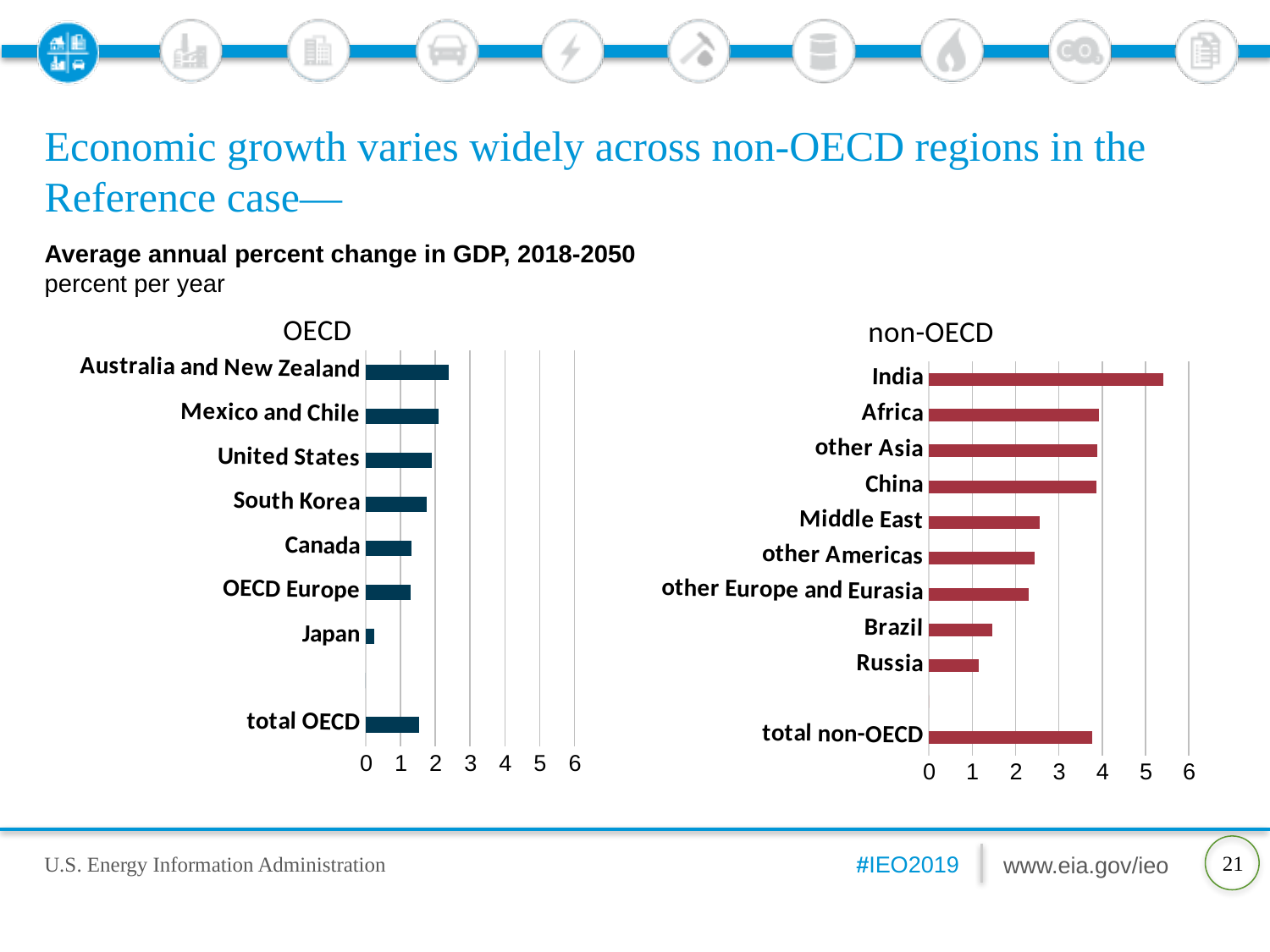
In the OECD chart, which is larger, the value for Canada or the value for Japan? Canada In the OECD chart, is the value for Australia and New Zealand greater or less than 2? greater In the non-OECD chart, is the value for India greater or less than 5? greater How many bars are shown in the non-OECD chart, including the total? 10 In the non-OECD chart, which region has the lowest average annual percent change in GDP? Russia In the OECD chart, which region has the lowest average annual percent change in GDP? Japan In the OECD chart, is the value for Japan greater or less than 1? less In the non-OECD chart, which is larger, the value for India or the value for China? India What kind of chart is the OECD chart? bar chart In the OECD chart, which region has the highest average annual percent change in GDP? Australia and New Zealand In the non-OECD chart, which region has the highest average annual percent change in GDP? India